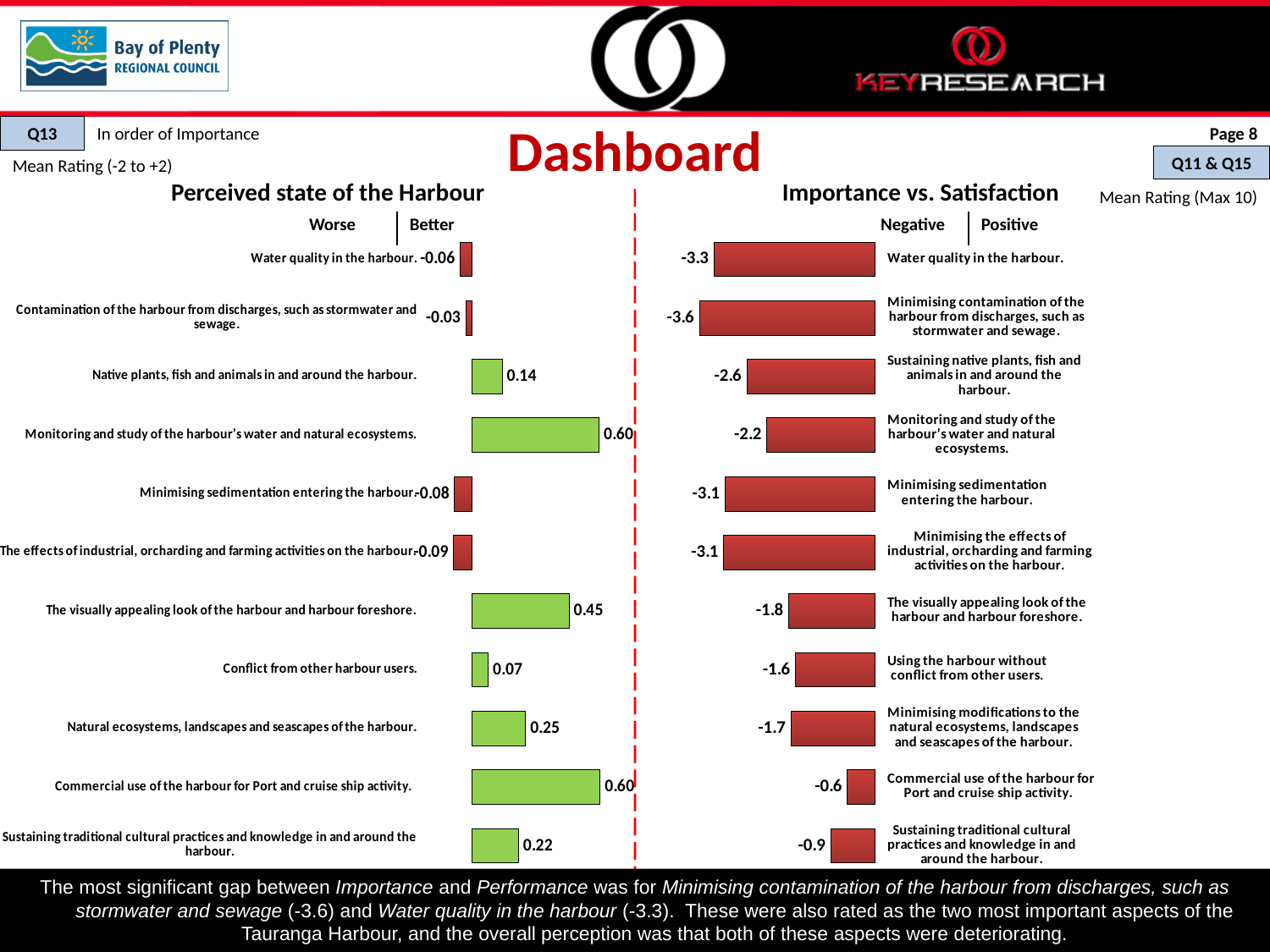
In the Importance vs. Satisfaction chart, what is the difference between the values for Water quality in the harbour (-3.3) and Minimising contamination of the harbour from discharges (-3.6)? 0.3 In the Perceived state of the Harbour chart, what is the value for Monitoring and study of the harbour's water and natural ecosystems? 0.60 In the Perceived state of the Harbour chart, what is the value for Water quality in the harbour? -0.06 In the Importance vs. Satisfaction chart, which category has the lowest (most negative) value? Minimising contamination of the harbour from discharges, such as stormwater and sewage. In the Importance vs. Satisfaction chart, which category has the highest (least negative) value? Commercial use of the harbour for Port and cruise ship activity. In the Importance vs. Satisfaction chart, what is the value for Commercial use of the harbour for Port and cruise ship activity? -0.6 What colour are the bars in the Importance vs. Satisfaction chart? Red How many categories are shown in the Perceived state of the Harbour chart? 11 In the Perceived state of the Harbour chart, which is larger: the value for Natural ecosystems, landscapes and seascapes of the harbour or the value for Conflict from other harbour users? Natural ecosystems, landscapes and seascapes of the harbour. In the Importance vs. Satisfaction chart, what is the value for Minimising contamination of the harbour from discharges, such as stormwater and sewage? -3.6 What type of chart is the Importance vs. Satisfaction chart? Bar chart In the Perceived state of the Harbour chart, what is the difference between the values for Commercial use of the harbour for Port and cruise ship activity and The visually appealing look of the harbour and harbour foreshore? 0.15